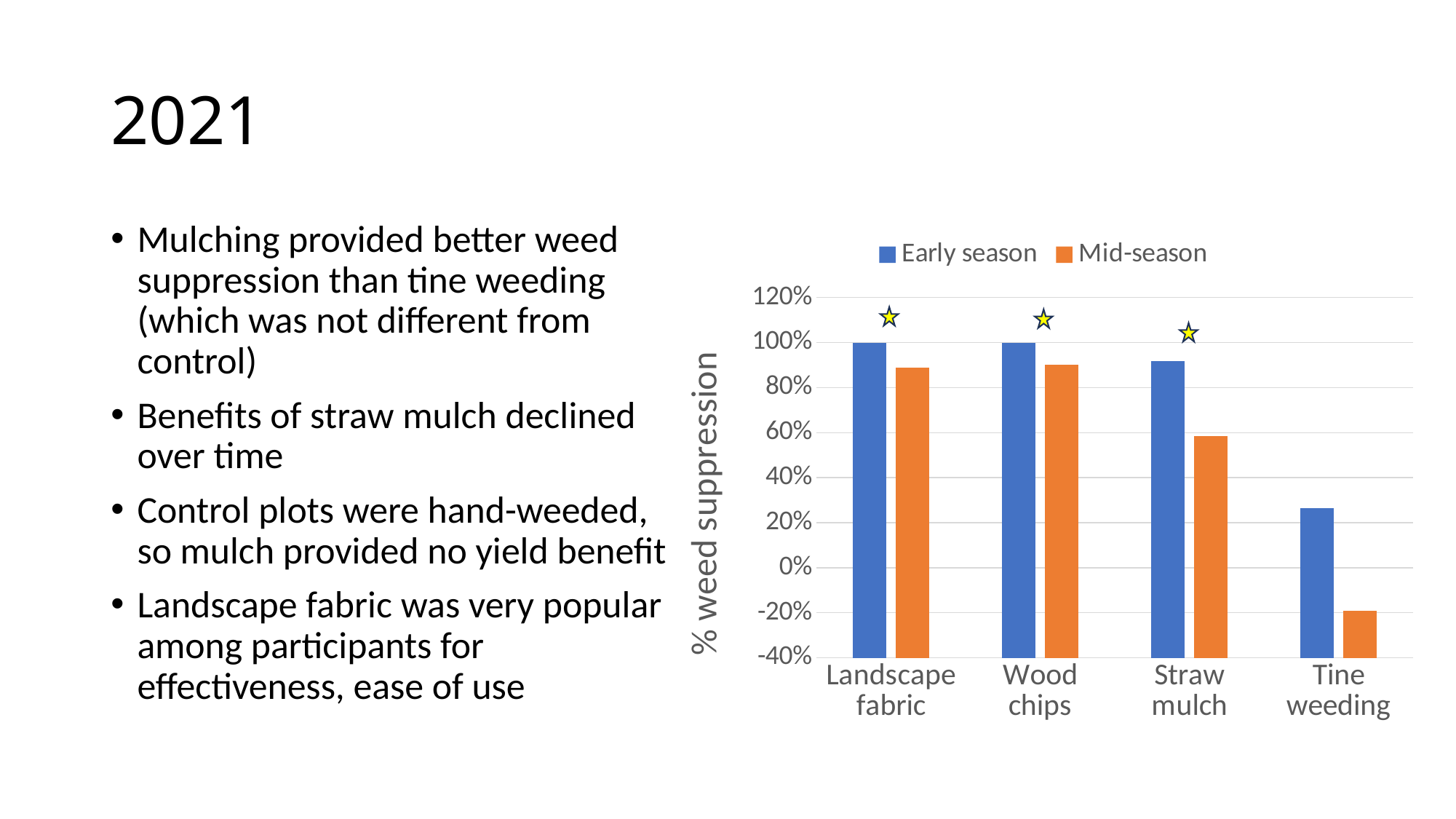
Do the Early season values generally rise or fall from left to right across the categories? fall For Straw mulch, which is larger: the Early season value or the Mid-season value? Early season Is the Mid-season value for Tine weeding greater or less than 0%? less Which is larger: the Mid-season value for Landscape fabric or the Mid-season value for Straw mulch? Landscape fabric Which category has the lowest Mid-season value? Tine weeding How many series does the legend list? 2 What kind of chart is shown on the slide? bar chart Which category has the lowest Early season value? Tine weeding Is the Early season value for Tine weeding greater or less than 40%? less How many categories are shown on the x axis? 4 What is the title of the vertical axis? % weed suppression Is the Mid-season value for Straw mulch greater or less than 80%? less